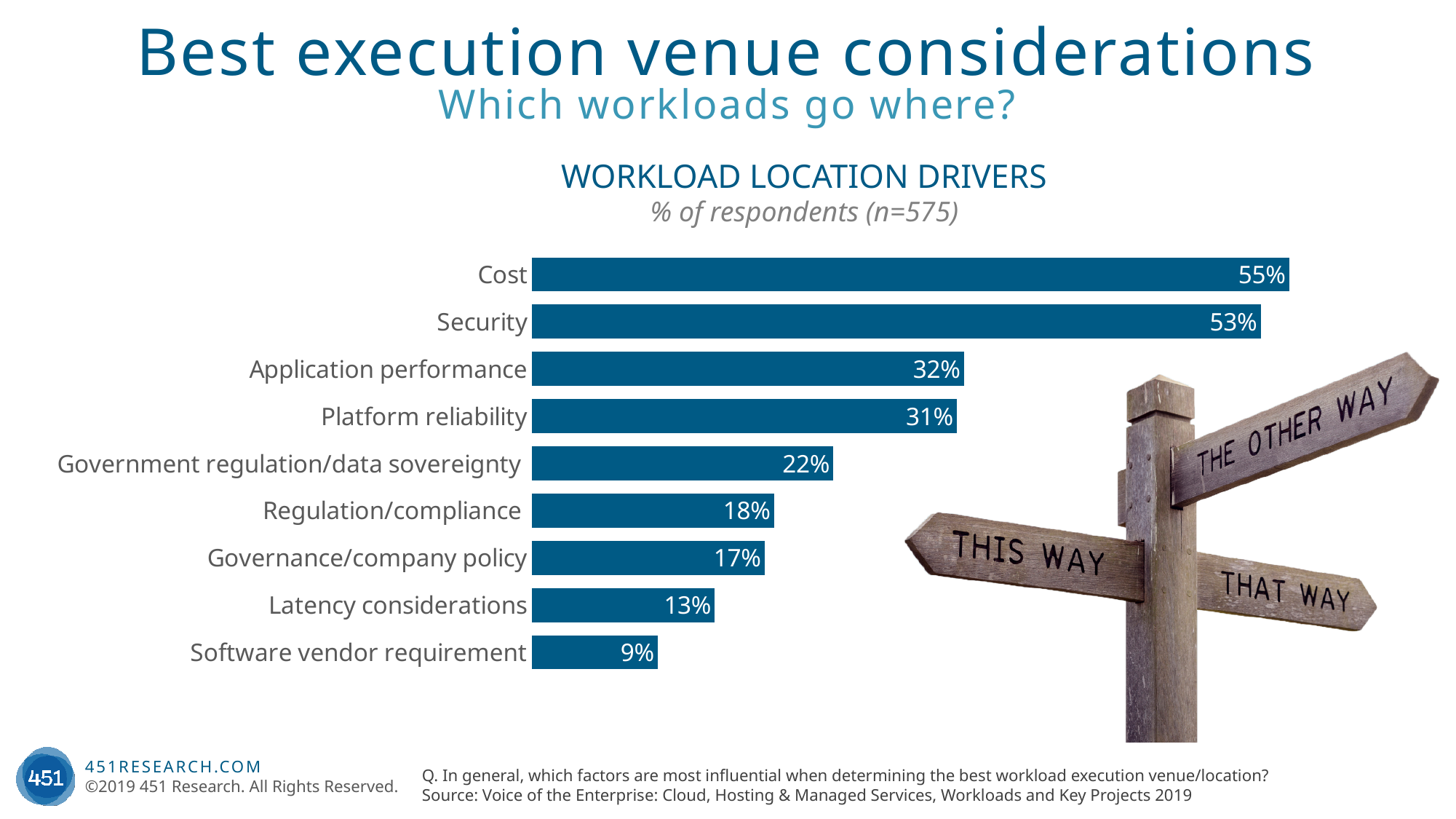
What percentage of respondents cited Latency considerations? 13% What percentage of respondents cited Cost as a workload location driver? 55% What is the difference in percentage points between Application performance and Software vendor requirement? 23 Which workload location driver has the lowest percentage of respondents? Software vendor requirement Which has a higher value, Regulation/compliance or Governance/company policy? Regulation/compliance How many workload location drivers are shown in the chart? 9 Which workload location driver has the highest percentage of respondents? Cost How many respondents (n) does the chart subtitle state? 575 What is the value for Government regulation/data sovereignty? 22% What is the difference in percentage points between Cost and Security? 2 What kind of chart is used to show the workload location drivers? Bar chart Which has a higher value, Platform reliability or Government regulation/data sovereignty? Platform reliability